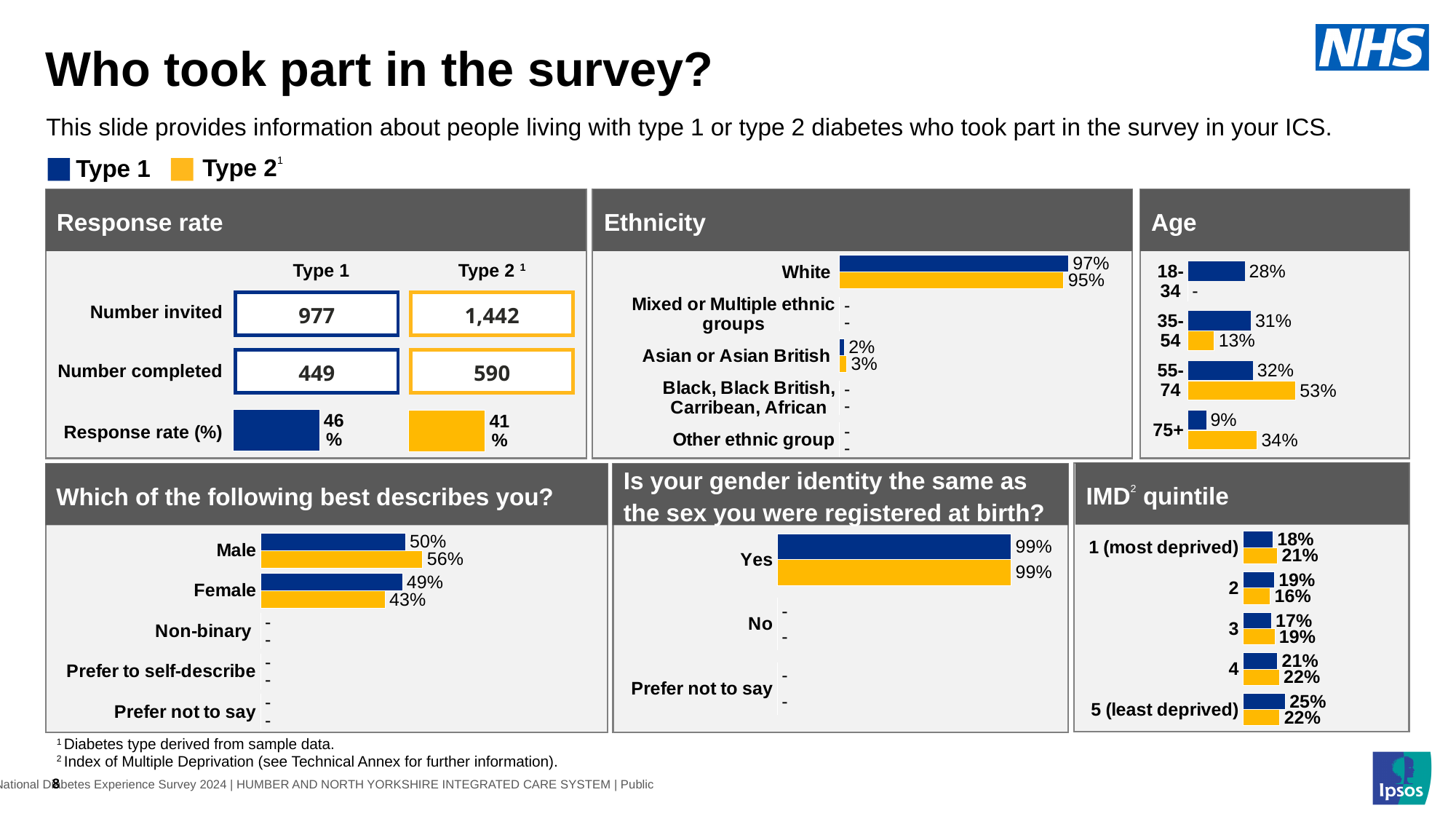
In the Age chart, which age group has the highest percentage of Type 2 respondents? 55-74 In the Age chart, what is the difference between the Type 2 and Type 1 percentages for the 75+ age group? 25% In the Age chart, what percentage of Type 2 respondents are aged 55-74? 53% In the Age chart, which age group has the lowest percentage of Type 1 respondents? 75+ In the IMD quintile chart, which quintile has the highest percentage of Type 1 respondents? 5 (least deprived) How many series does the legend at the top of the slide list? 2 In the IMD quintile chart, what percentage of Type 1 respondents are in quintile 5 (least deprived)? 25% In the 'Which of the following best describes you?' chart, what percentage of Type 2 respondents are Male? 56% In the Response rate chart, what is the response rate for Type 2? 41% In the 'Which of the following best describes you?' chart, is the Female percentage higher for Type 1 or Type 2? Type 1 In the Ethnicity chart, what percentage of Type 1 respondents are White? 97% In the Ethnicity chart, what percentage of Type 2 respondents are Asian or Asian British? 3%